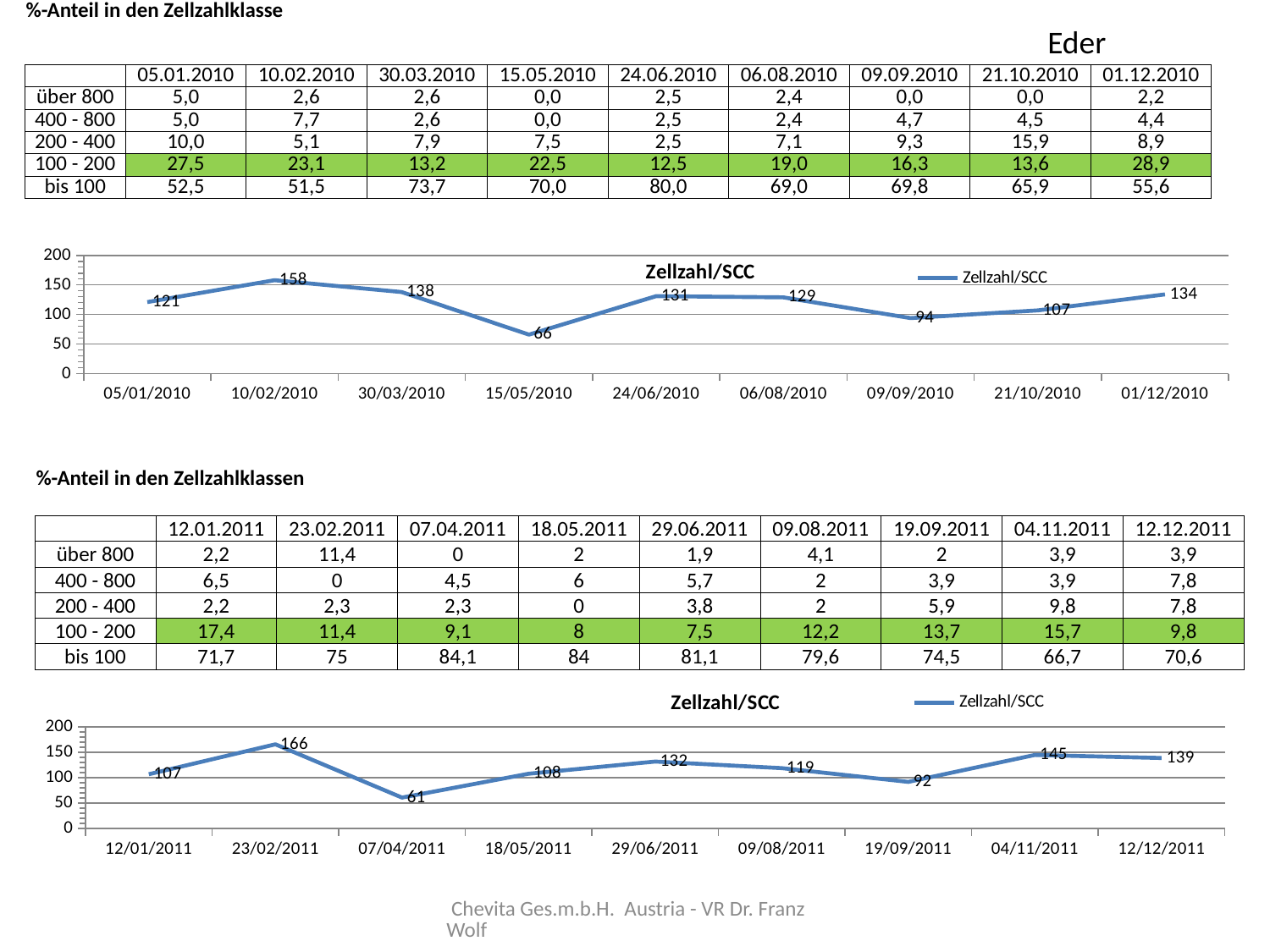
In the upper Zellzahl/SCC chart (2010), what is the difference between the values for 10/02/2010 and 15/05/2010? 92 In the upper Zellzahl/SCC chart (2010), how many data points are plotted? 9 What type of chart is the lower Zellzahl/SCC chart (2011)? line chart In the upper Zellzahl/SCC chart (2010), which date has the highest value? 10/02/2010 In the lower Zellzahl/SCC chart (2011), what is the difference between the values for 04/11/2011 and 19/09/2011? 53 In the upper Zellzahl/SCC chart (2010), what is the value for 15/05/2010? 66 In the upper Zellzahl/SCC chart (2010), which date has the lowest value? 15/05/2010 In the lower Zellzahl/SCC chart (2011), which date has the lowest value? 07/04/2011 In the upper Zellzahl/SCC chart (2010), what is the value for 10/02/2010? 158 In the lower Zellzahl/SCC chart (2011), what is the value for 23/02/2011? 166 How many series does the legend of the upper Zellzahl/SCC chart (2010) list? 1 In the lower Zellzahl/SCC chart (2011), which is larger, the value for 04/11/2011 or the value for 12/12/2011? 04/11/2011